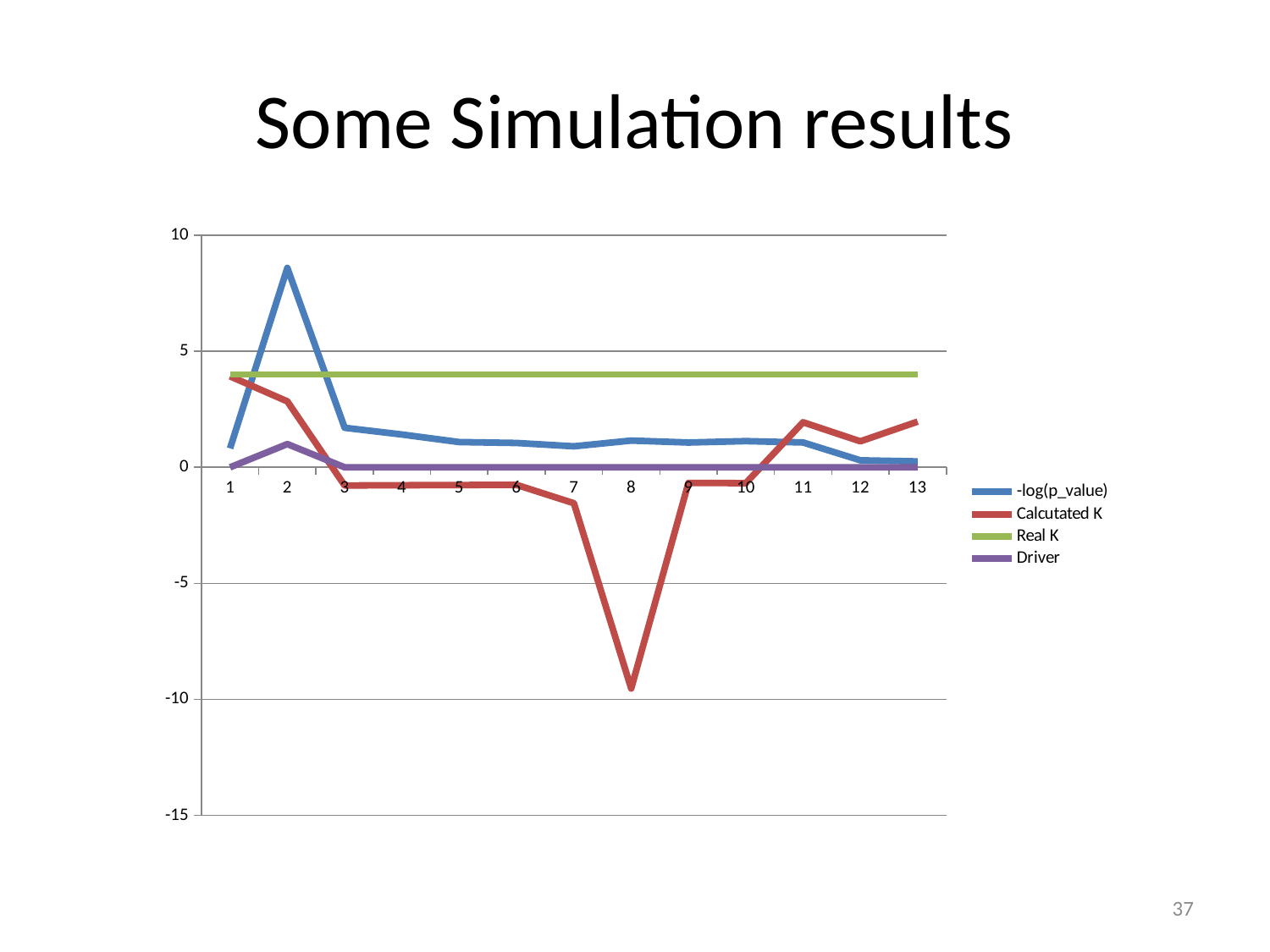
How many points are plotted along the x axis for each series? 13 Is the value of Calcutated K at x = 8 greater or less than -5? less How many series does the legend list? 4 Is the value of -log(p_value) at x = 2 greater or less than 5? greater Is the value of the Real K series greater or less than 5? less What kind of chart is shown on the slide? line chart At which x value does the Calcutated K series reach its lowest point? 8 Does the Calcutated K series rise or fall from x = 1 to x = 3? fall What is the title of the slide containing the chart? Some Simulation results What is the value of the Driver series at x = 5? 0 At which x value does the -log(p_value) series reach its highest point? 2 At x = 2, which series has the larger value, -log(p_value) or Calcutated K? -log(p_value)